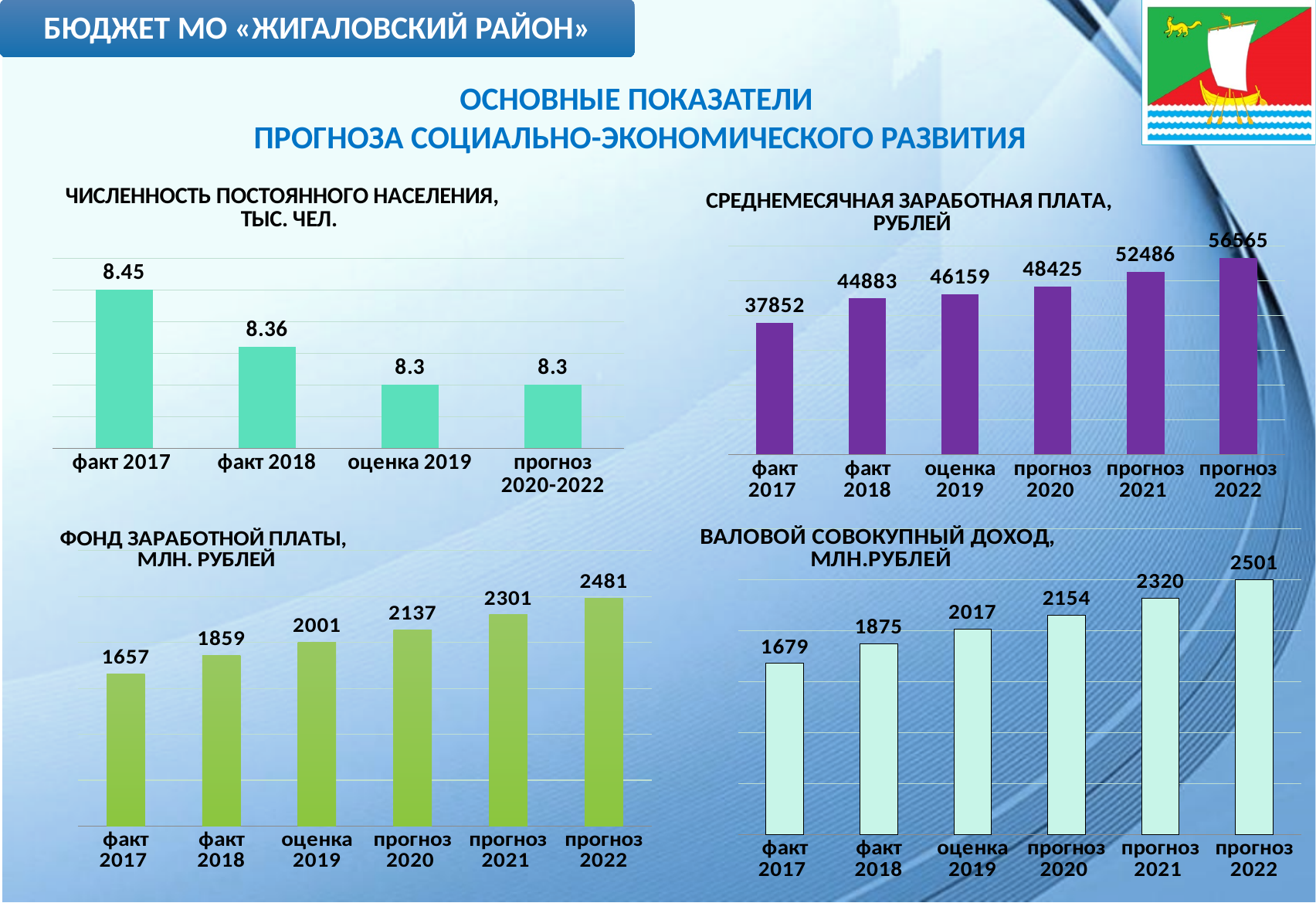
In the chart 'СРЕДНЕМЕСЯЧНАЯ ЗАРАБОТНАЯ ПЛАТА, РУБЛЕЙ', what is the difference between прогноз 2022 and факт 2017? 18713 In the chart 'ФОНД ЗАРАБОТНОЙ ПЛАТЫ, МЛН. РУБЛЕЙ', which category has the lowest value? факт 2017 In the chart 'ФОНД ЗАРАБОТНОЙ ПЛАТЫ, МЛН. РУБЛЕЙ', what is the value for прогноз 2021? 2301 In the chart 'ЧИСЛЕННОСТЬ ПОСТОЯННОГО НАСЕЛЕНИЯ, ТЫС. ЧЕЛ.', do the values rise or fall from факт 2017 to прогноз 2020-2022? fall In the chart 'ВАЛОВОЙ СОВОКУПНЫЙ ДОХОД, МЛН.РУБЛЕЙ', what is the value for прогноз 2020? 2154 In the chart 'ВАЛОВОЙ СОВОКУПНЫЙ ДОХОД, МЛН.РУБЛЕЙ', which is larger: оценка 2019 or факт 2018? оценка 2019 In the chart 'СРЕДНЕМЕСЯЧНАЯ ЗАРАБОТНАЯ ПЛАТА, РУБЛЕЙ', what is the value for оценка 2019? 46159 In the chart 'ЧИСЛЕННОСТЬ ПОСТОЯННОГО НАСЕЛЕНИЯ, ТЫС. ЧЕЛ.', what is the value for факт 2017? 8.45 What type of chart is 'ВАЛОВОЙ СОВОКУПНЫЙ ДОХОД, МЛН.РУБЛЕЙ'? bar chart In the chart 'ФОНД ЗАРАБОТНОЙ ПЛАТЫ, МЛН. РУБЛЕЙ', what is the difference between факт 2018 and факт 2017? 202 In the chart 'СРЕДНЕМЕСЯЧНАЯ ЗАРАБОТНАЯ ПЛАТА, РУБЛЕЙ', which category has the highest value? прогноз 2022 In the chart 'ЧИСЛЕННОСТЬ ПОСТОЯННОГО НАСЕЛЕНИЯ, ТЫС. ЧЕЛ.', how many bars are plotted? 4